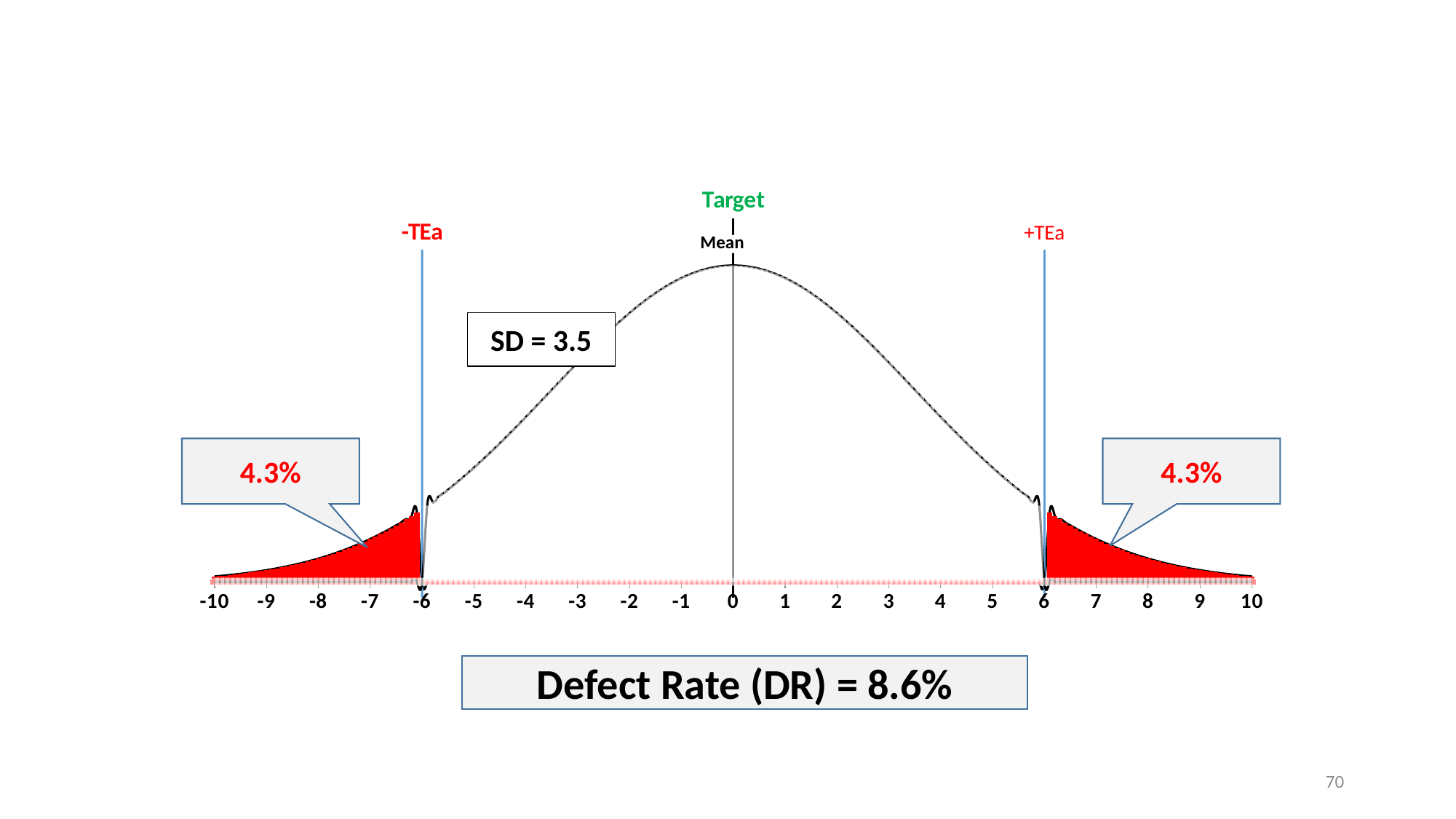
What is the Defect Rate (DR) shown below the chart? 8.6% What is the combined percentage of the two red tails (4.3% and 4.3%)? 8.6% What percentage is shown in the callout for the left red tail beyond -TEa? 4.3% At which x-axis value is the Mean / Target line located? 0 What colour are the shaded tail areas beyond the TEa lines? red Does the curve rise or fall as x goes from 0 to 10? fall What percentage is shown in the callout for the right red tail beyond +TEa? 4.3% How many tick labels are shown on the x axis from -10 to 10? 21 At which x-axis value is the -TEa line located? -6 What kind of chart is shown on the slide? line chart At which x-axis value is the +TEa line located? 6 What is the standard deviation (SD) shown on the chart? 3.5